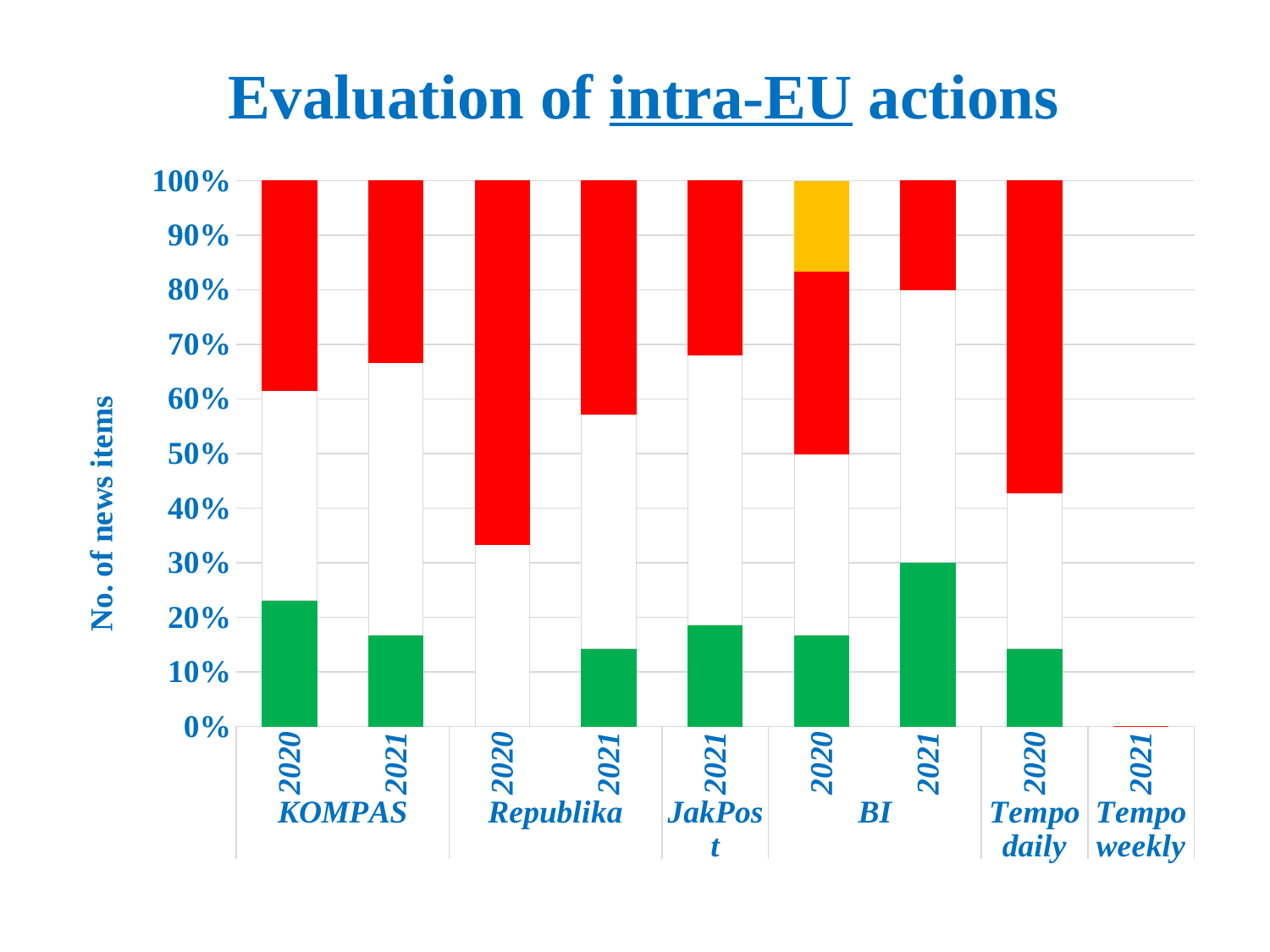
Is the green segment for Tempo daily 2020 greater or less than 20%? less Which bars have no green segment at all? Republika 2020 and Tempo weekly 2021 Is the top of the red segment for BI 2020 greater or less than 90%? less Which bar contains a yellow segment? BI 2020 Which bar has the largest red segment? Republika 2020 What kind of chart is shown on the slide? Stacked bar chart Is the bottom of the red segment for Republika 2020 greater or less than 40%? less What is the title of the chart? Evaluation of intra-EU actions Which has the larger green segment, KOMPAS 2020 or KOMPAS 2021? KOMPAS 2020 Which bar has the largest green segment? BI 2021